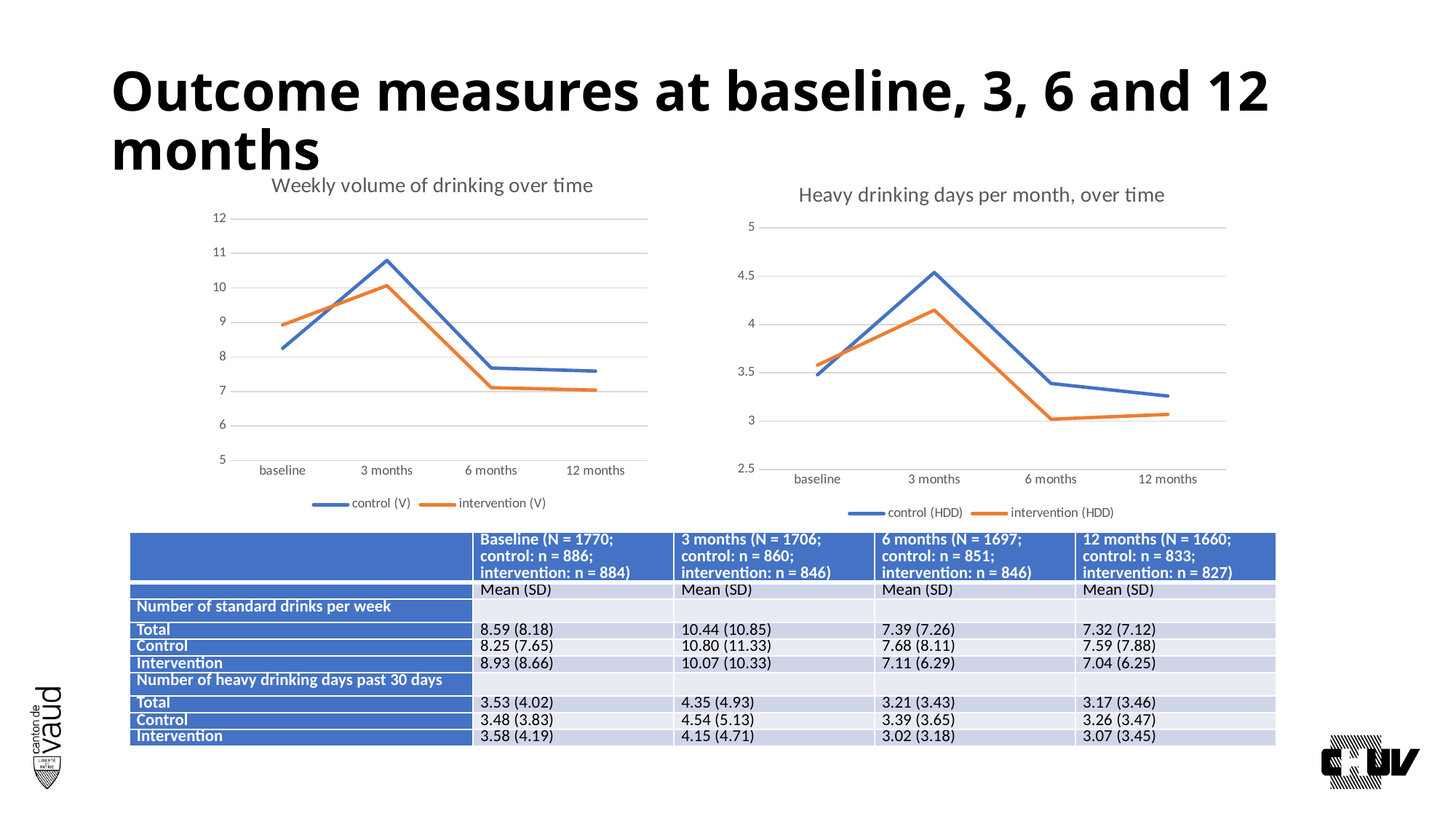
How many time points are plotted along the x axis of the 'Heavy drinking days per month, over time' chart? 4 How many series does the legend of the 'Weekly volume of drinking over time' chart list? 2 What kind of chart is the 'Weekly volume of drinking over time' chart? line chart In the 'Heavy drinking days per month, over time' chart, is the value for intervention (HDD) at 6 months greater or less than 3.5? less In the 'Weekly volume of drinking over time' chart, which series has the larger value at baseline, control (V) or intervention (V)? intervention (V) In the 'Weekly volume of drinking over time' chart, does the control (V) series rise or fall from 3 months to 12 months? fall What are the two legend entries of the 'Heavy drinking days per month, over time' chart? control (HDD) and intervention (HDD) In the 'Weekly volume of drinking over time' chart, is the value for control (V) at 3 months greater or less than 10? greater In the 'Weekly volume of drinking over time' chart, at which time point does the control (V) series reach its highest value? 3 months In the 'Heavy drinking days per month, over time' chart, at which time point is the control (HDD) series lowest? 12 months In the 'Heavy drinking days per month, over time' chart, which series is higher at 3 months, control (HDD) or intervention (HDD)? control (HDD) According to the table below the charts, what is the mean number of standard drinks per week for the control group at 3 months? 10.80